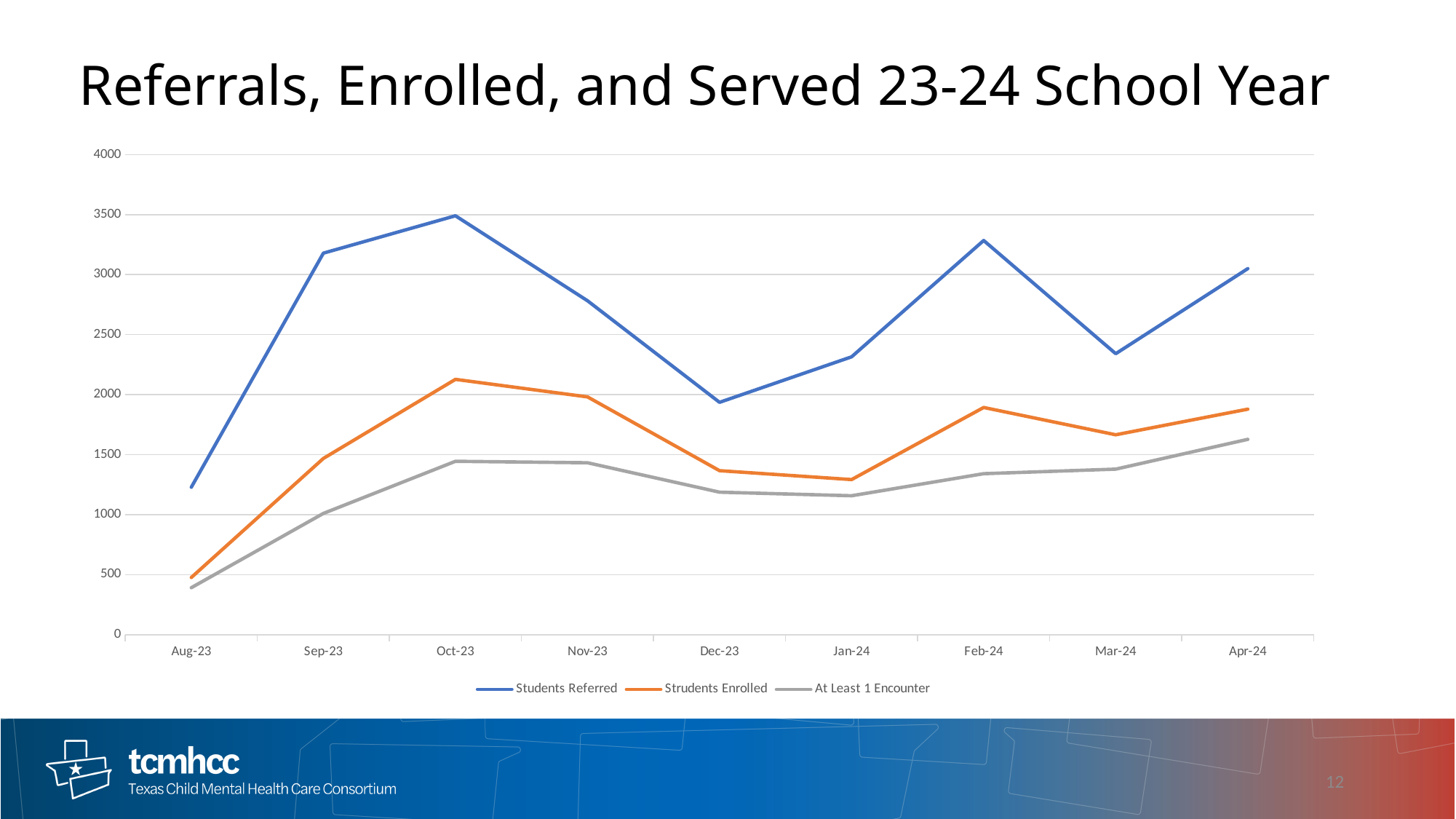
How many series does the legend list? 3 Is the value for Students Referred in Oct-23 greater or less than 3000? greater In which month is the Students Referred line at its lowest? Aug-23 Is the value for Students Referred in Dec-23 greater or less than 2500? less In which month is the Students Referred line at its highest? Oct-23 Does the Students Referred line rise or fall from Aug-23 to Oct-23? rise Is the value for At Least 1 Encounter in Apr-24 greater or less than 1500? greater What kind of chart is shown on the slide? line chart In which month is the At Least 1 Encounter line at its highest? Apr-24 In which month is the Strudents Enrolled line at its lowest? Aug-23 Which is larger in Feb-24, Students Referred or Strudents Enrolled? Students Referred How many months are plotted along the x axis? 9